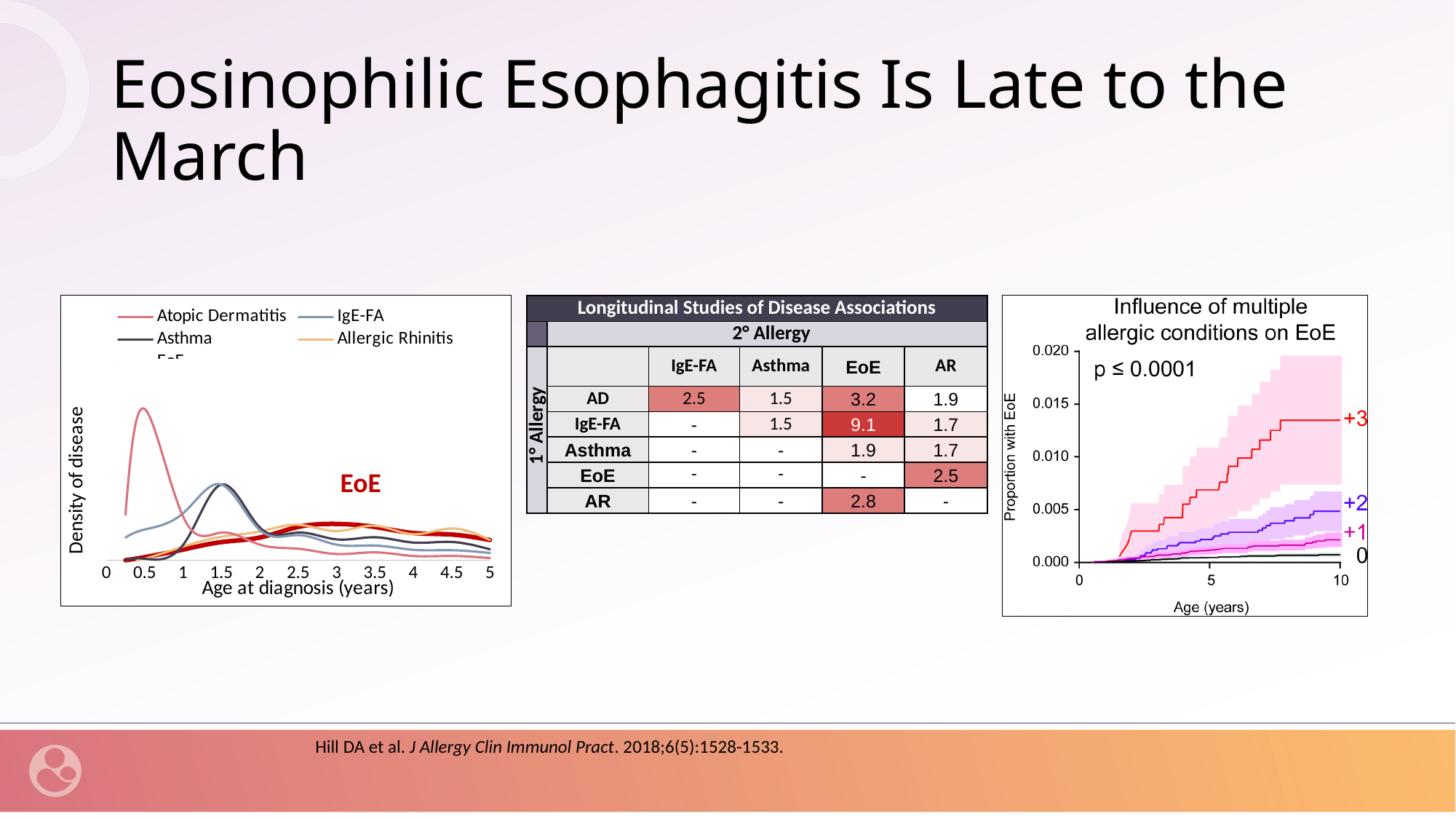
In the left chart (Density of disease), does the Atopic Dermatitis curve rise or fall between age 0.5 and age 2 years? fall In the right chart (Influence of multiple allergic conditions on EoE), which line has the lowest proportion with EoE at age 10? 0 In the right chart (Influence of multiple allergic conditions on EoE), which line has the highest proportion with EoE at age 10? +3 In the left chart (Density of disease), what is the label on the x axis? Age at diagnosis (years) What is the title of the right chart? Influence of multiple allergic conditions on EoE In the right chart (Influence of multiple allergic conditions on EoE), is the proportion with EoE for the +1 line at age 10 greater or less than 0.005? less In the left chart (Density of disease), which series has the highest peak? Atopic Dermatitis What kind of chart is the left chart showing density of disease by age at diagnosis? line chart In the left chart (Density of disease), which series peaks at the earliest age at diagnosis? Atopic Dermatitis In the left chart (Density of disease), how many series does the legend list? 5 In the right chart (Influence of multiple allergic conditions on EoE), how many lines are plotted? 4 In the right chart (Influence of multiple allergic conditions on EoE), is the proportion with EoE for the +3 line at age 10 greater or less than 0.010? greater